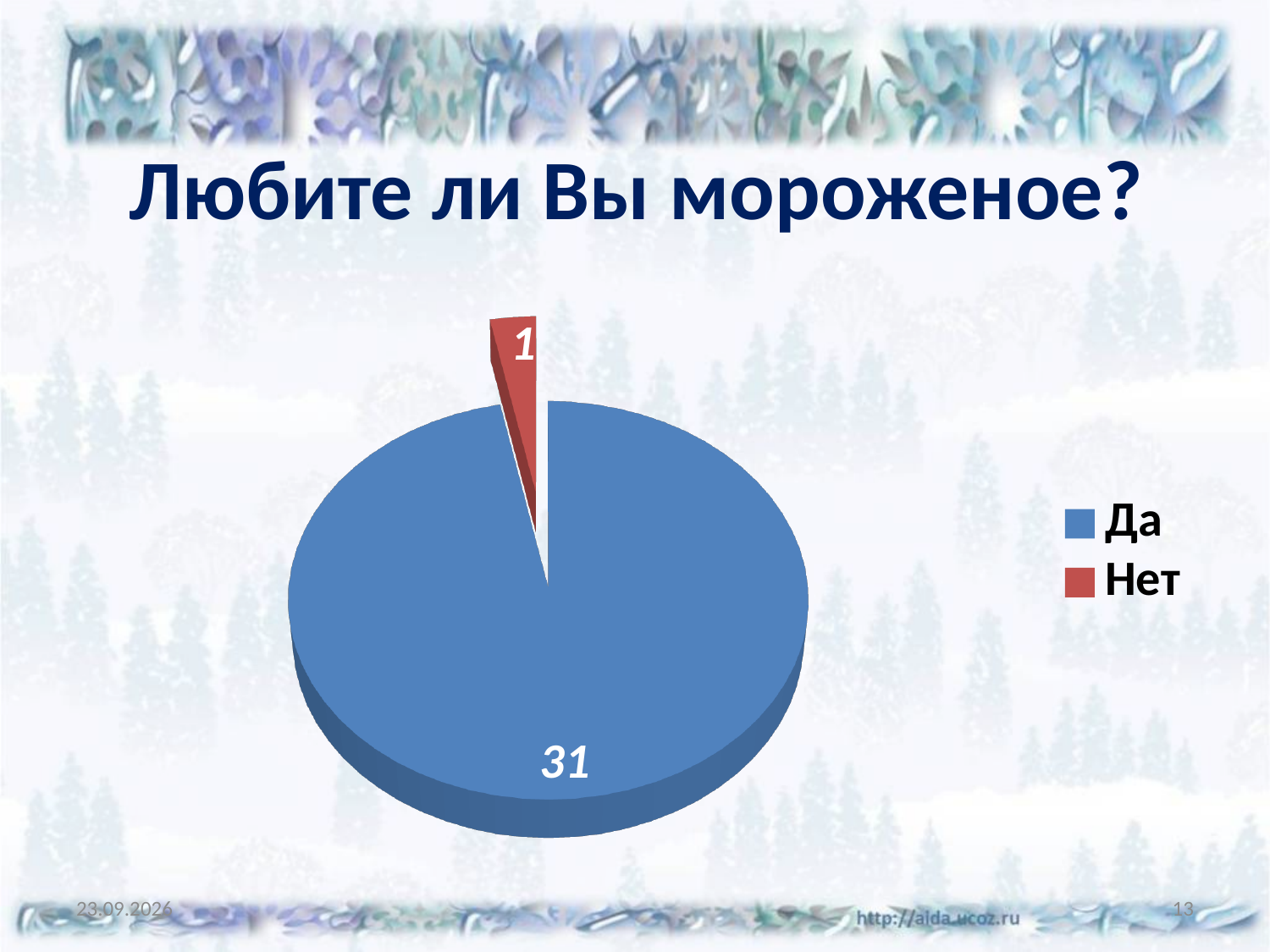
Which category has the largest slice? Да What is the value for "Да"? 31 What colour is the slice for "Нет"? red Which category has the smallest slice? Нет What kind of chart is shown on the slide? pie chart What is the title of the slide containing the chart? Любите ли Вы мороженое? What is the difference between the values for "Да" and "Нет"? 30 Which is larger, the value for "Да" or the value for "Нет"? Да What is the total of all slices in the pie chart? 32 How many entries does the legend list? 2 What is the value for "Нет"? 1 How many categories does the pie chart have? 2